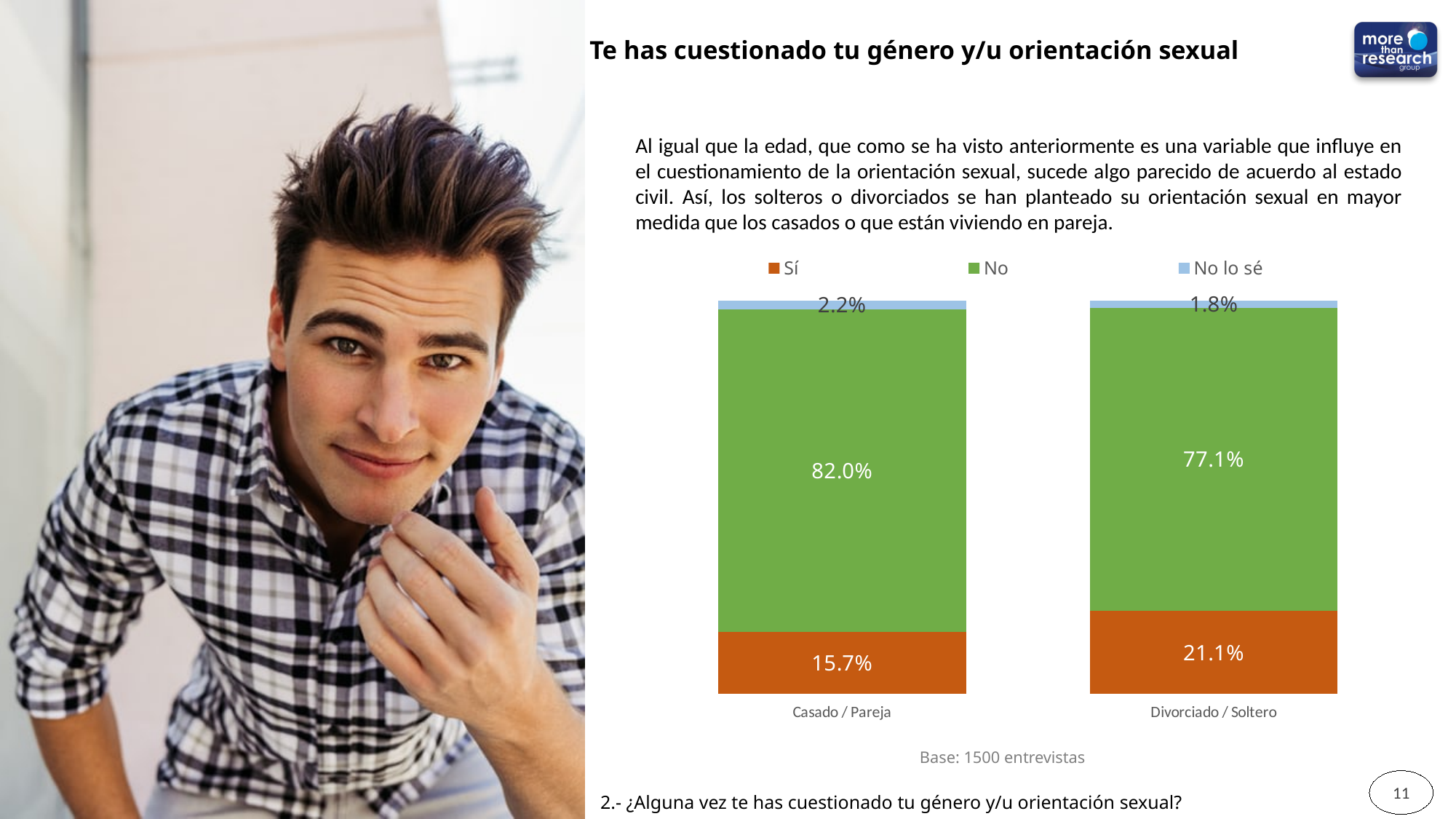
What is the No lo sé value for Casado / Pareja? 2.2% What type of chart is shown on the slide? Stacked bar chart What percentage of Casado / Pareja respondents answered Sí? 15.7% How many series does the chart legend list? 3 Which category has the higher Sí percentage? Divorciado / Soltero What is the difference in the No percentage between Casado / Pareja and Divorciado / Soltero? 4.9 percentage points How many categories are shown on the x axis of the chart? 2 What is the difference in the Sí percentage between Divorciado / Soltero and Casado / Pareja? 5.4 percentage points What is the Sí value for Divorciado / Soltero? 21.1% Is the No value larger for Casado / Pareja or for Divorciado / Soltero? Casado / Pareja Which category has the lower No lo sé percentage? Divorciado / Soltero What percentage of Divorciado / Soltero respondents answered No? 77.1%